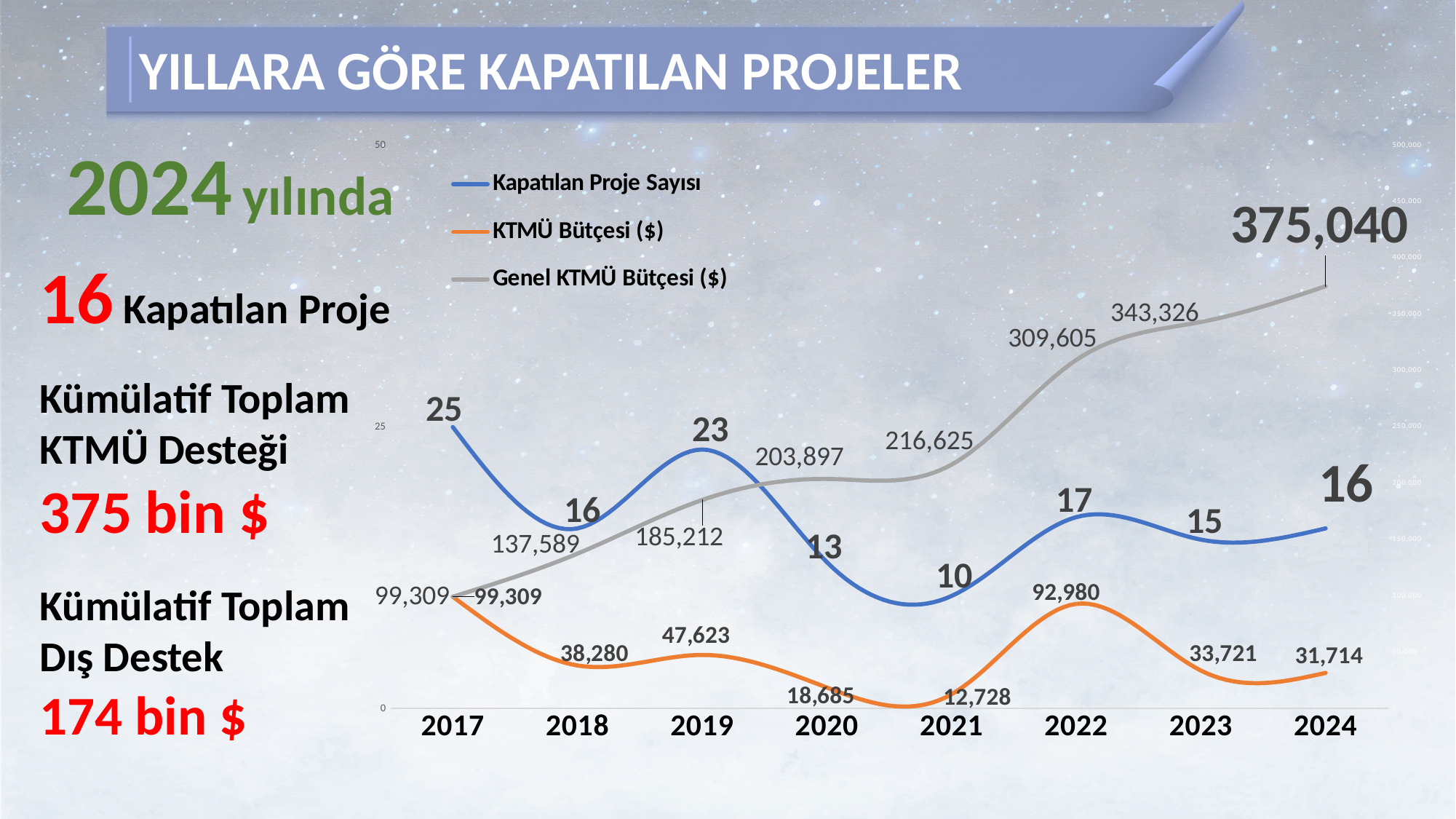
How many series does the chart legend list? 3 What is the value of Kapatılan Proje Sayısı in 2019? 23 What is the Genel KTMÜ Bütçesi ($) value for 2024? 375,040 How many years are shown on the x axis of the chart? 8 In which year is Kapatılan Proje Sayısı the highest? 2017 In which year is KTMÜ Bütçesi ($) the lowest? 2021 Does Genel KTMÜ Bütçesi ($) rise or fall from 2017 to 2024? rise Which is larger, KTMÜ Bütçesi ($) in 2018 or in 2019? 2019 What is the difference between Kapatılan Proje Sayısı in 2017 and in 2024? 9 What kind of chart is shown on the slide? line chart What is the KTMÜ Bütçesi ($) value for 2022? 92,980 In which year is Kapatılan Proje Sayısı the lowest? 2021